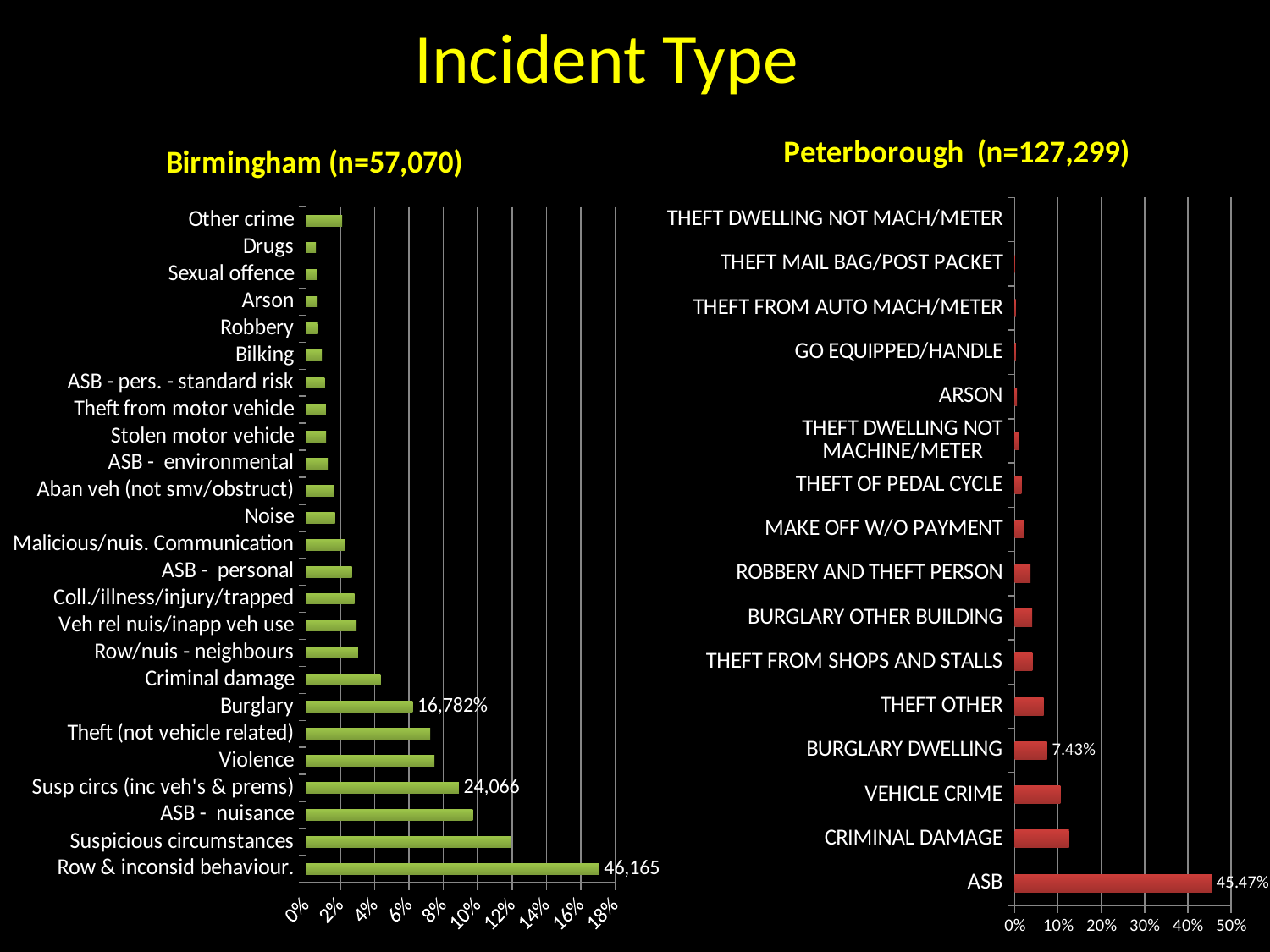
On the Peterborough chart, what value is shown for ASB? 45.47% On the Birmingham chart, is the value for Criminal damage greater or less than 6%? less What kind of chart is the Peterborough chart? bar chart On the Peterborough chart, what value is shown for BURGLARY DWELLING? 7.43% On the Birmingham chart, which incident type has the longest bar? Row & inconsid behaviour. On the Peterborough chart, is the value for CRIMINAL DAMAGE greater or less than 20%? less How many incident types are plotted on the Peterborough chart? 16 What sample size (n) is given in the title of the Birmingham chart? 57,070 On the Peterborough chart, which incident type has the highest value? ASB On the Birmingham chart, which is larger: the value for Suspicious circumstances or the value for Violence? Suspicious circumstances How many incident types are plotted on the Birmingham chart? 25 On the Peterborough chart, what is the difference between the values for ASB and BURGLARY DWELLING? 38.04%